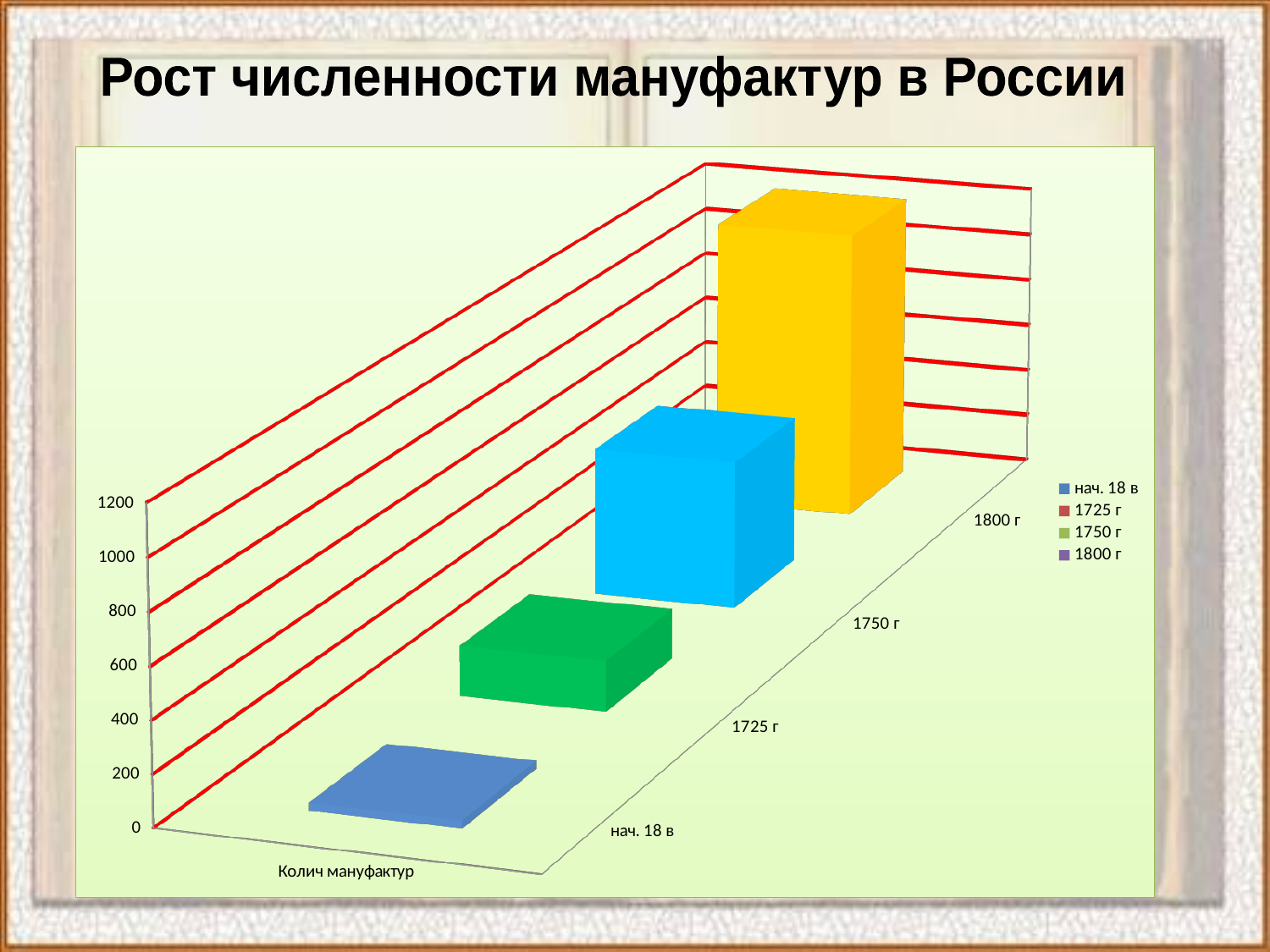
Is the value for 1725 г greater or less than 600? less Which series has the lowest bar? нач. 18 в Which is larger, the bar for 1750 г or the bar for 1725 г? 1750 г Do the bars rise or fall from нач. 18 в to 1800 г? rise Is the value for 1750 г greater or less than 200? greater Is the value for 1800 г greater or less than 600? greater What kind of chart is shown on the slide? bar chart What is the title of the slide's chart? Рост численности мануфактур в России Which series has the highest bar? 1800 г How many series does the legend list? 4 What label is shown on the category axis of the chart? Колич мануфактур